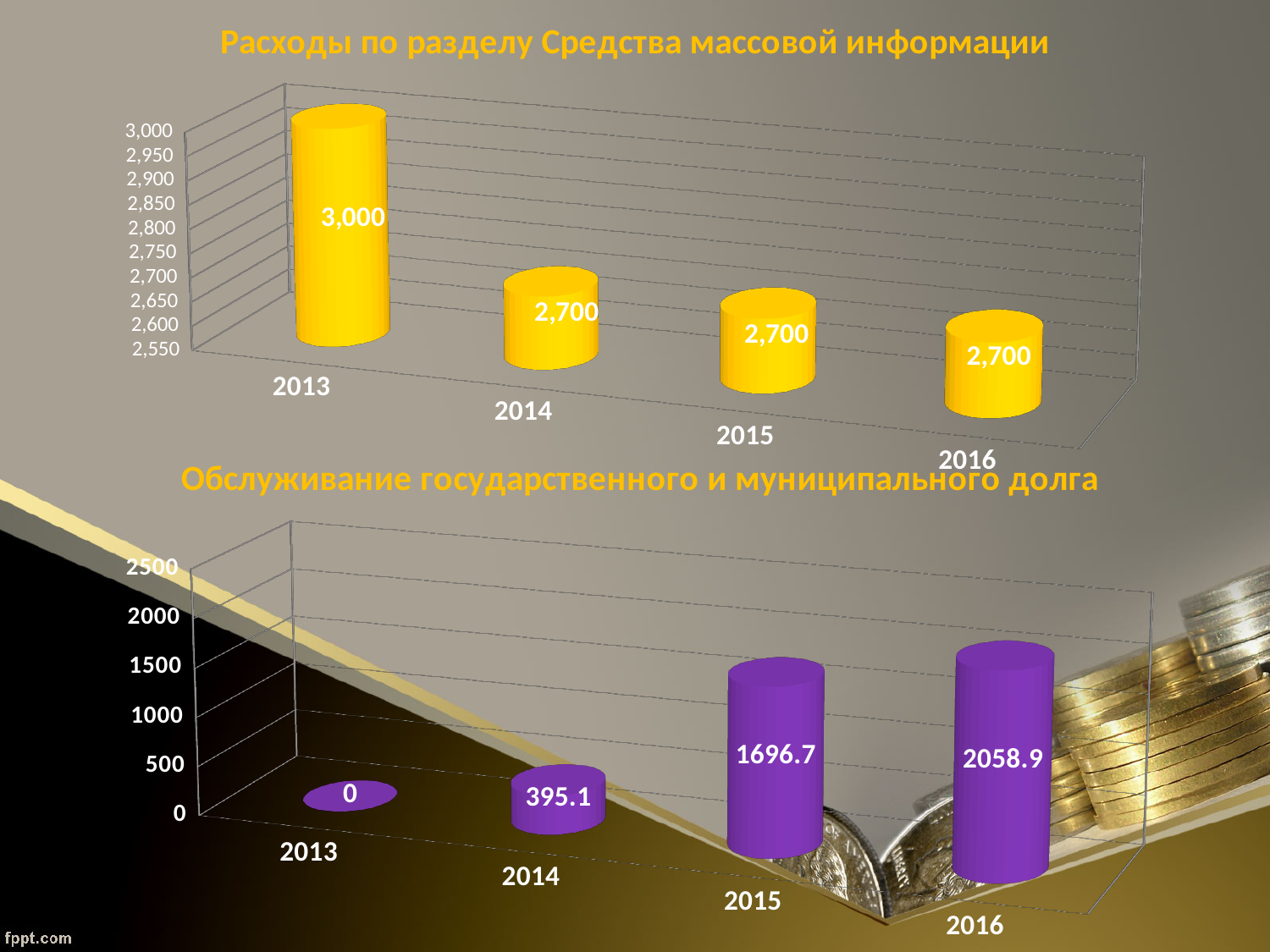
In the chart titled 'Расходы по разделу Средства массовой информации', what is the value for 2015? 2,700 In the chart titled 'Расходы по разделу Средства массовой информации', which year has the highest value? 2013 In the chart titled 'Обслуживание государственного и муниципального долга', what is the value for 2014? 395.1 In the chart titled 'Обслуживание государственного и муниципального долга', do the values rise or fall from 2013 to 2016? rise In the chart titled 'Обслуживание государственного и муниципального долга', what is the value for 2016? 2058.9 In the chart titled 'Обслуживание государственного и муниципального долга', which year has the lowest value? 2013 In the chart titled 'Расходы по разделу Средства массовой информации', how many years are shown on the x axis? 4 What type of chart is the bottom chart on the slide? bar chart In the chart titled 'Расходы по разделу Средства массовой информации', what is the difference between the values for 2013 and 2014? 300 In the chart titled 'Обслуживание государственного и муниципального долга', what is the difference between the values for 2016 and 2015? 362.2 In the chart titled 'Обслуживание государственного и муниципального долга', which is larger, the value for 2015 or the value for 2016? 2016 In the chart titled 'Расходы по разделу Средства массовой информации', what is the value for 2013? 3,000